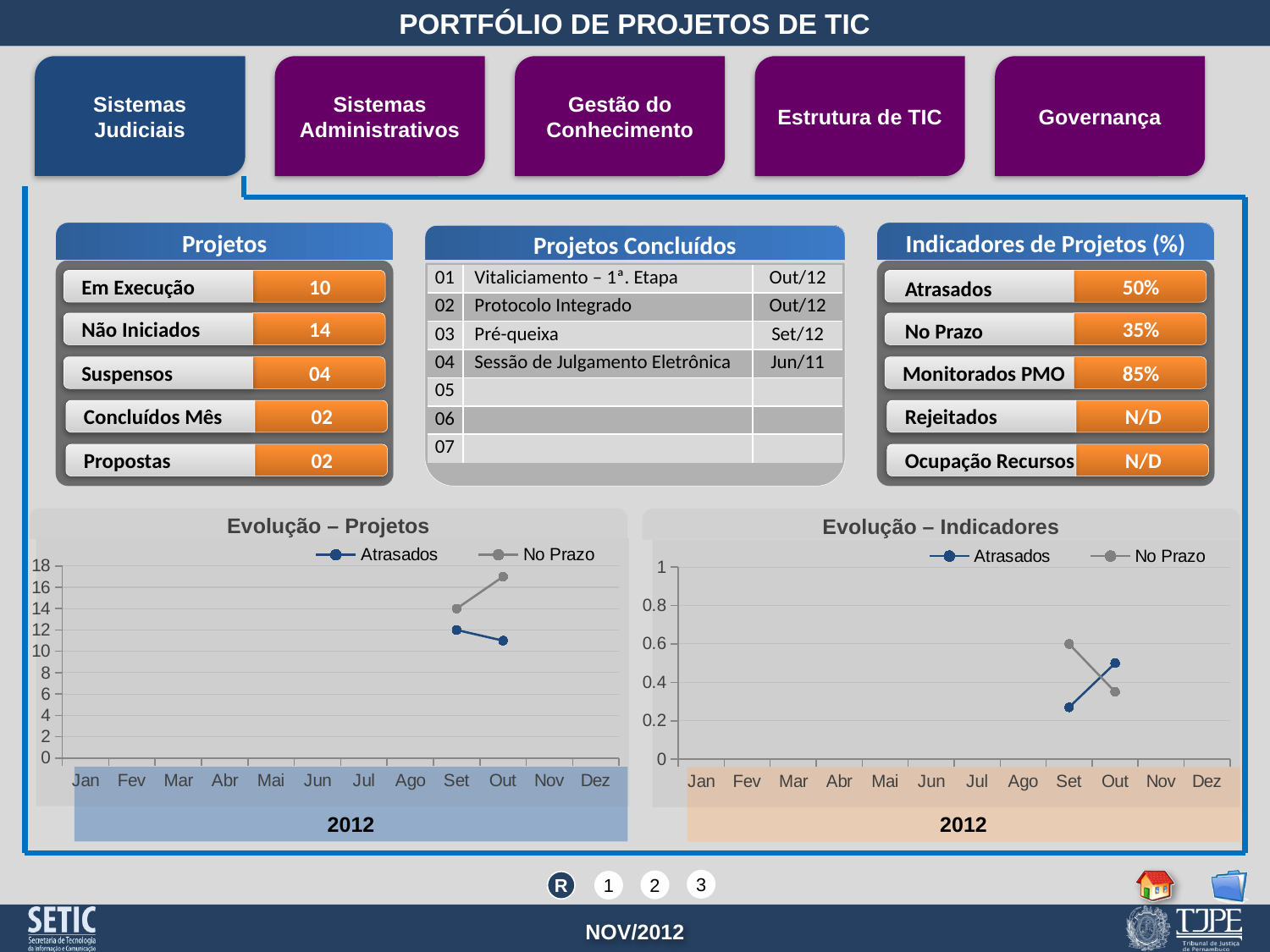
In the 'Evolução – Projetos' chart, what kind of chart is it? line chart In the 'Evolução – Indicadores' chart, is the Atrasados value for Set greater or less than 0.4? less In the 'Evolução – Indicadores' chart, which series has the larger value in Set, Atrasados or No Prazo? No Prazo In the 'Evolução – Projetos' chart, what are the two series named in the legend? Atrasados and No Prazo In the 'Evolução – Projetos' chart, does the No Prazo series rise or fall from Set to Out? rise In the 'Evolução – Indicadores' chart, how many series does the legend list? 2 In the 'Evolução – Indicadores' chart, which series has the larger value in Out, Atrasados or No Prazo? Atrasados In the 'Evolução – Projetos' chart, does the Atrasados series rise or fall from Set to Out? fall In the 'Evolução – Indicadores' chart, does the Atrasados series rise or fall from Set to Out? rise In the 'Evolução – Projetos' chart, which series has the larger value in Out, Atrasados or No Prazo? No Prazo In the 'Evolução – Projetos' chart, is the No Prazo value for Out greater or less than 16? greater In the 'Evolução – Projetos' chart, how many months are shown on the x axis? 12